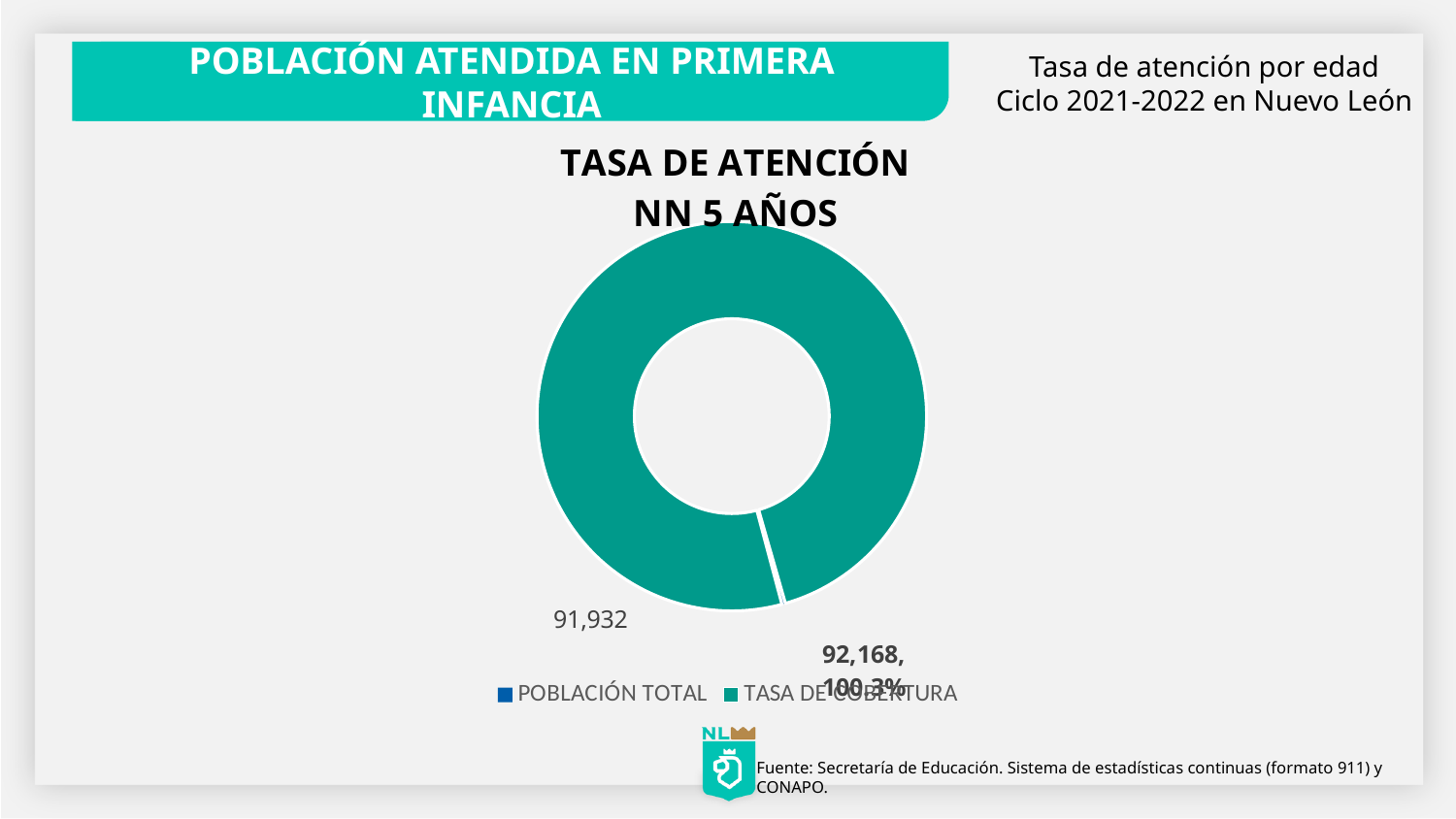
How many entries does the chart legend list? 2 What value is shown for TASA DE COBERTURA? 92,168 Which is larger, the value for POBLACIÓN TOTAL or the value for TASA DE COBERTURA? TASA DE COBERTURA What kind of chart is shown on the slide? Doughnut chart What percentage is printed next to the 92,168 data label? 100.3% What is the difference between the two values shown, 92,168 and 91,932? 236 Which legend entry is shown in blue? POBLACIÓN TOTAL What value is shown for POBLACIÓN TOTAL? 91,932 How many slices does the doughnut chart have? 1 What is the title of the chart? TASA DE ATENCIÓN NN 5 AÑOS